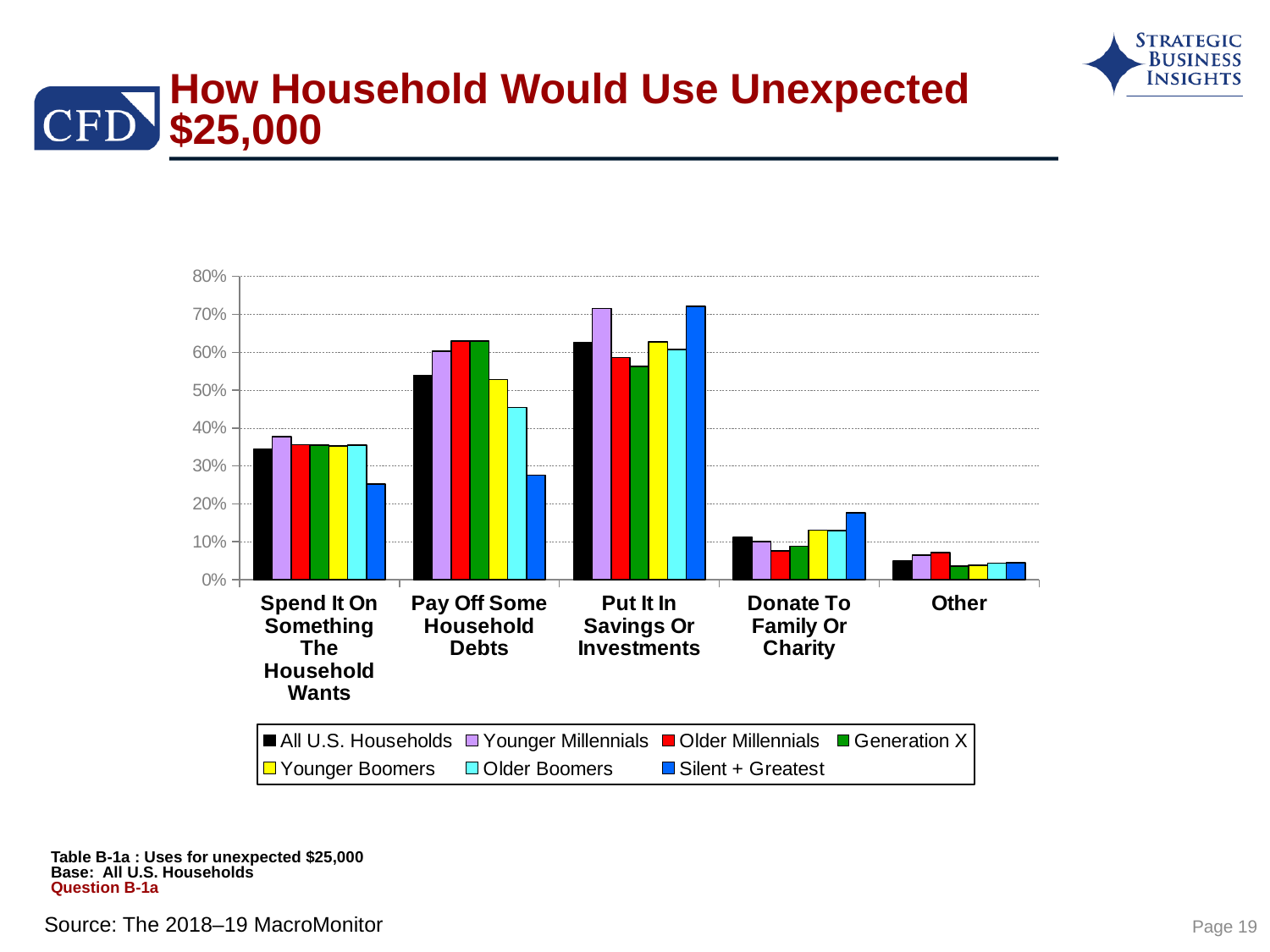
In the "Put It In Savings Or Investments" category, which is larger: Younger Millennials or Generation X? Younger Millennials What colour represents the Silent + Greatest series in the chart? blue Is the value for Younger Millennials in the "Put It In Savings Or Investments" category greater or less than 60%? greater Is the value for All U.S. Households in the "Donate To Family Or Charity" category greater or less than 20%? less In the "Pay Off Some Household Debts" category, which is larger: Older Boomers or Silent + Greatest? Older Boomers Is the value for Silent + Greatest in the "Pay Off Some Household Debts" category greater or less than 40%? less How many series does the chart's legend list? 7 Which series has the lowest value in the "Spend It On Something The Household Wants" category? Silent + Greatest Which series has the highest value in the "Donate To Family Or Charity" category? Silent + Greatest How many categories are shown along the x axis of the chart? 5 What kind of chart is shown on the slide? bar chart For the All U.S. Households series, which category has the lowest value? Other